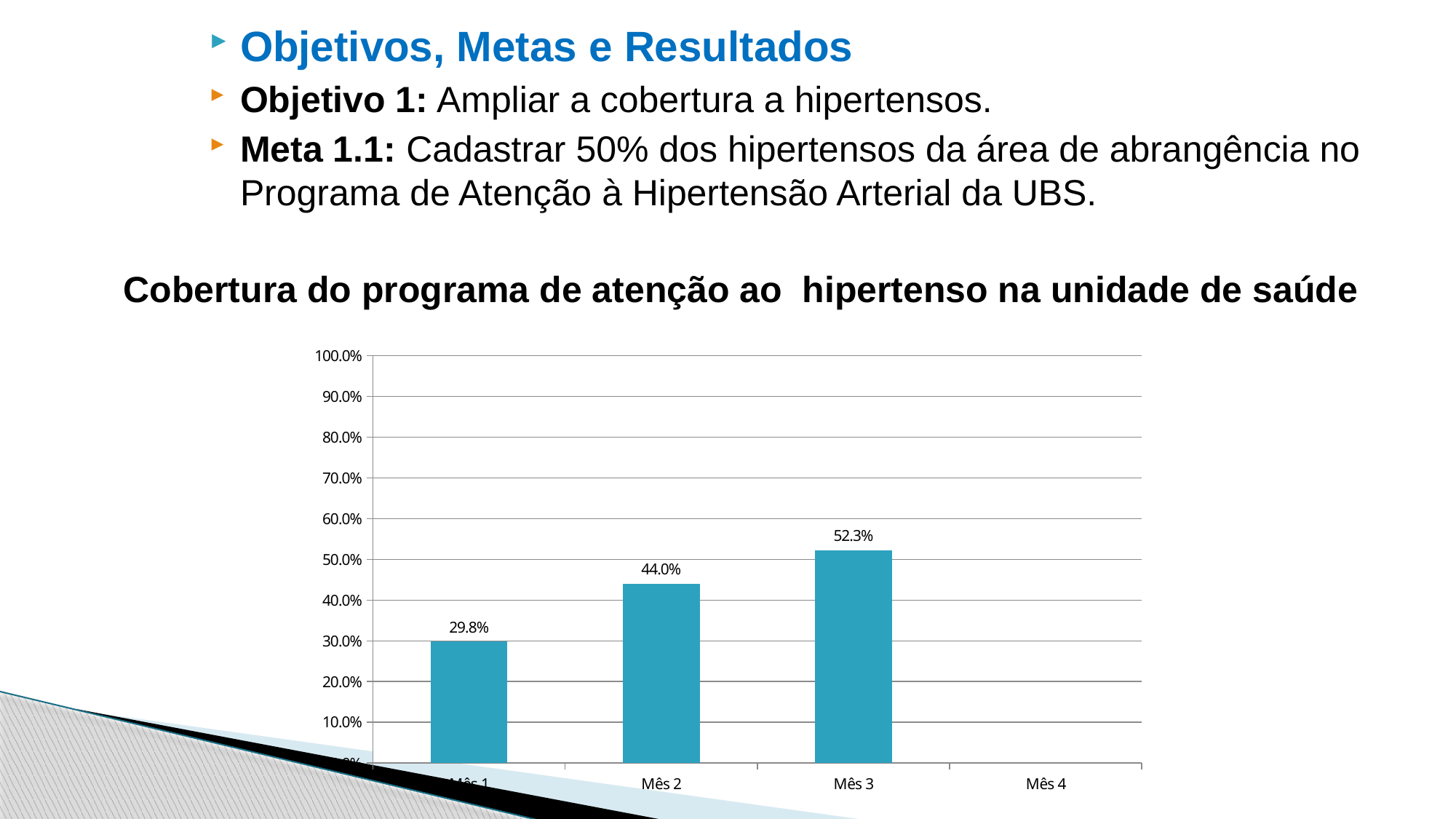
What is the coverage value shown for Mês 2? 44.0% Which is larger, the value for Mês 1 or the value for Mês 2? Mês 2 What is the coverage value shown for Mês 1? 29.8% Which month has the highest coverage value? Mês 3 What is the difference between the coverage values for Mês 3 and Mês 2? 8.3% Is the value for Mês 3 greater or less than 50.0%? greater What is the difference between the coverage values for Mês 2 and Mês 1? 14.2% Among the months with a plotted bar, which has the lowest coverage value? Mês 1 Do the coverage values rise or fall from Mês 1 to Mês 3? Rise What kind of chart is shown on the slide? Bar chart How many bars are plotted in the chart? 3 What is the coverage value shown for Mês 3? 52.3%